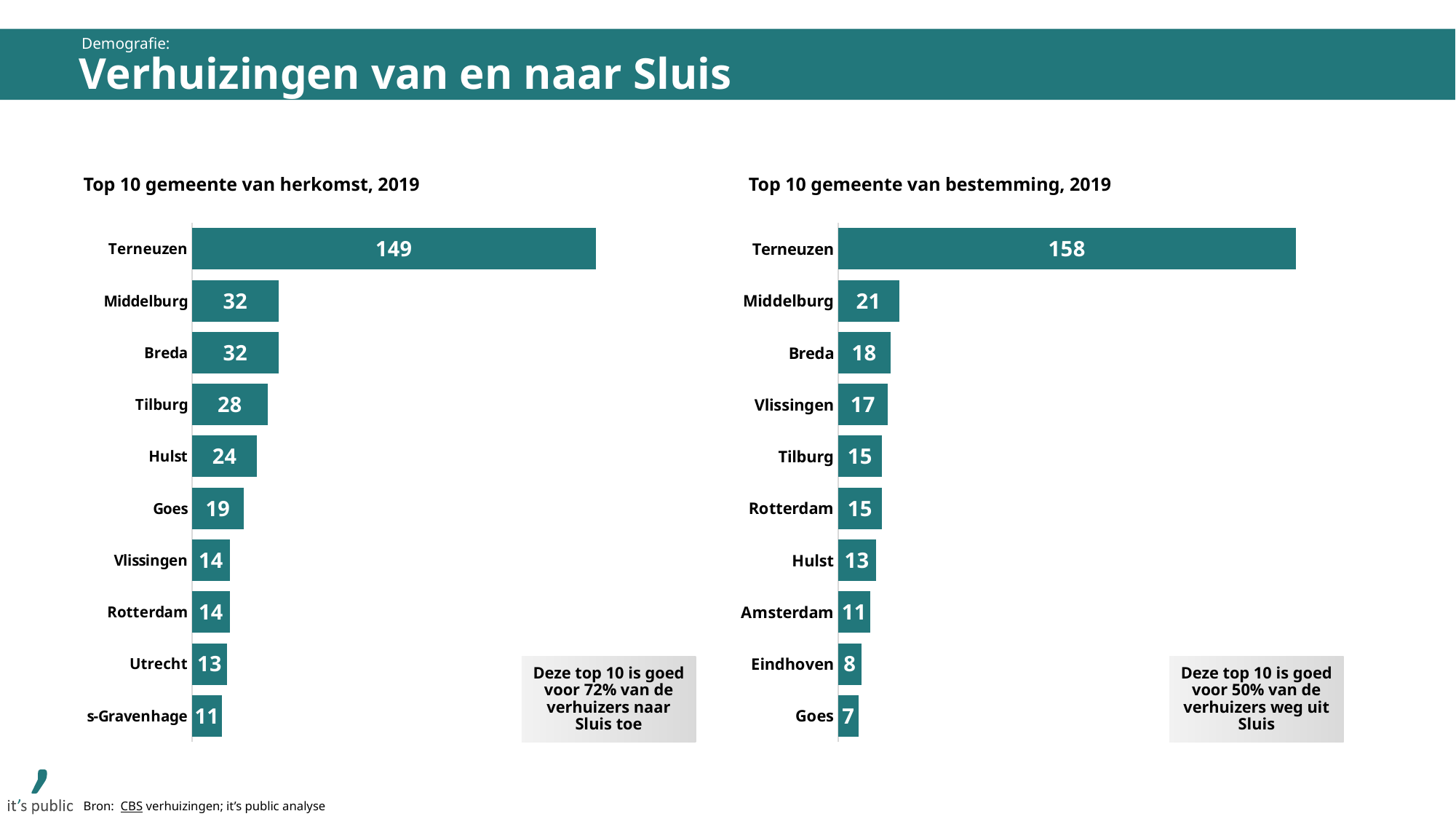
According to the text box on the 'Top 10 gemeente van herkomst, 2019' chart, what share of movers to Sluis does the top 10 account for? 72% In the chart 'Top 10 gemeente van herkomst, 2019', what is the difference between Terneuzen and Middelburg? 117 In the chart 'Top 10 gemeente van bestemming, 2019', what is the difference between Middelburg and Breda? 3 In the chart 'Top 10 gemeente van bestemming, 2019', which municipality has the lowest value? Goes In the chart 'Top 10 gemeente van herkomst, 2019', what is the value for Hulst? 24 In the chart 'Top 10 gemeente van herkomst, 2019', how many municipalities are shown? 10 In the chart 'Top 10 gemeente van herkomst, 2019', what is the value for Terneuzen? 149 In the chart 'Top 10 gemeente van herkomst, 2019', which municipality has the lowest value? s-Gravenhage In the chart 'Top 10 gemeente van bestemming, 2019', which municipality has the highest value? Terneuzen Which is larger: the value for Terneuzen in the 'herkomst' chart or the value for Terneuzen in the 'bestemming' chart? Terneuzen in the 'bestemming' chart (158) In the chart 'Top 10 gemeente van bestemming, 2019', what is the value for Vlissingen? 17 What type of chart is 'Top 10 gemeente van bestemming, 2019'? Bar chart